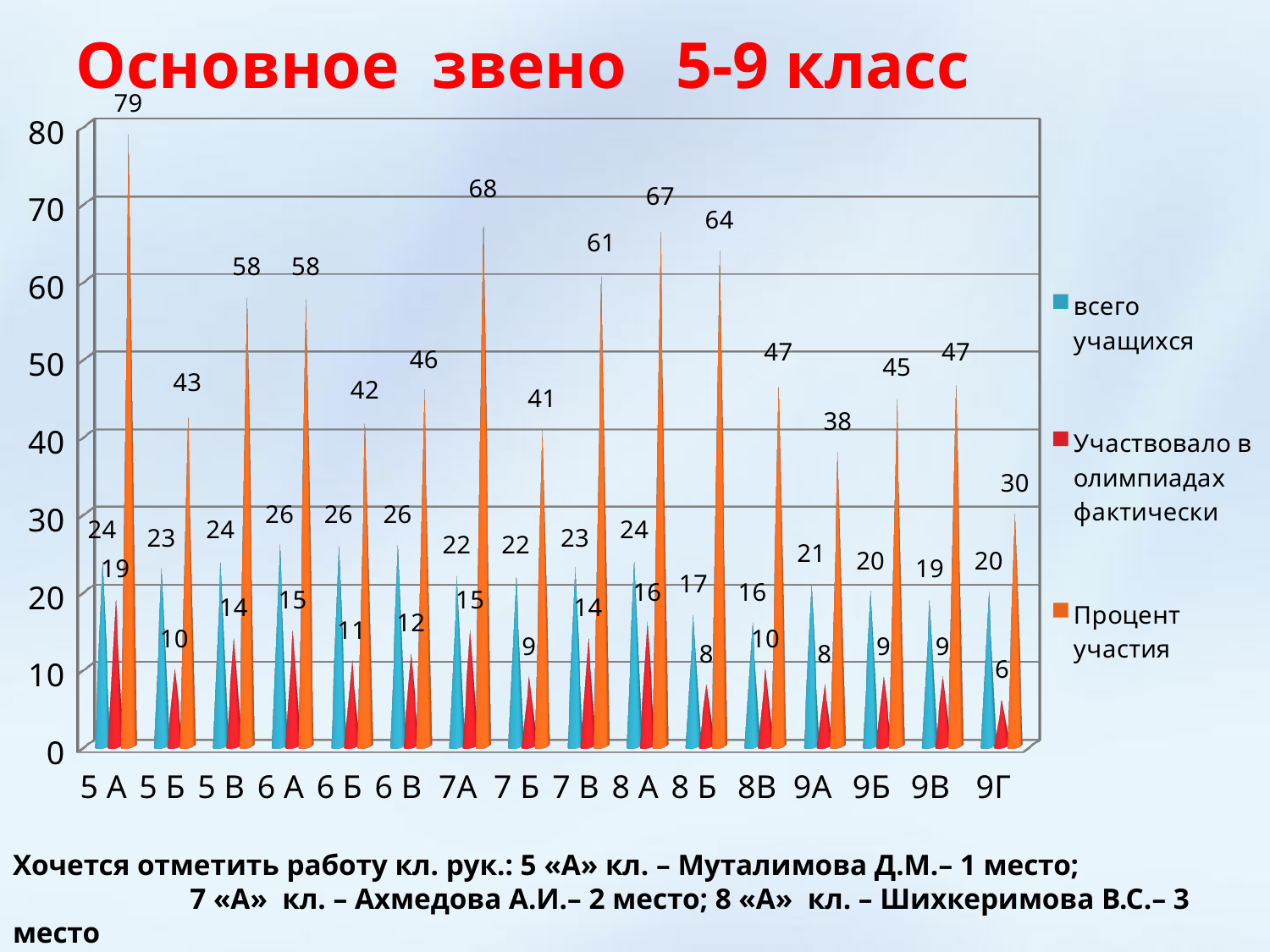
What is the difference between Процент участия for 7А and for 7 Б? 27 What is the value of Процент участия for 5 А? 79 Which class has the lowest Процент участия? 9Г What type of chart is shown on the slide? bar chart How many series does the legend list? 3 What is the value of всего учащихся for 7 В? 23 What is the value of Участвовало в олимпиадах фактически for 9Г? 6 Which is larger: Процент участия for 5 В or for 6 В? 5 В What is the title of the chart on the slide? Основное звено 5-9 класс Which class has the highest Процент участия? 5 А How many classes (categories) are shown on the x axis? 16 Which class has the lowest всего учащихся value? 8В